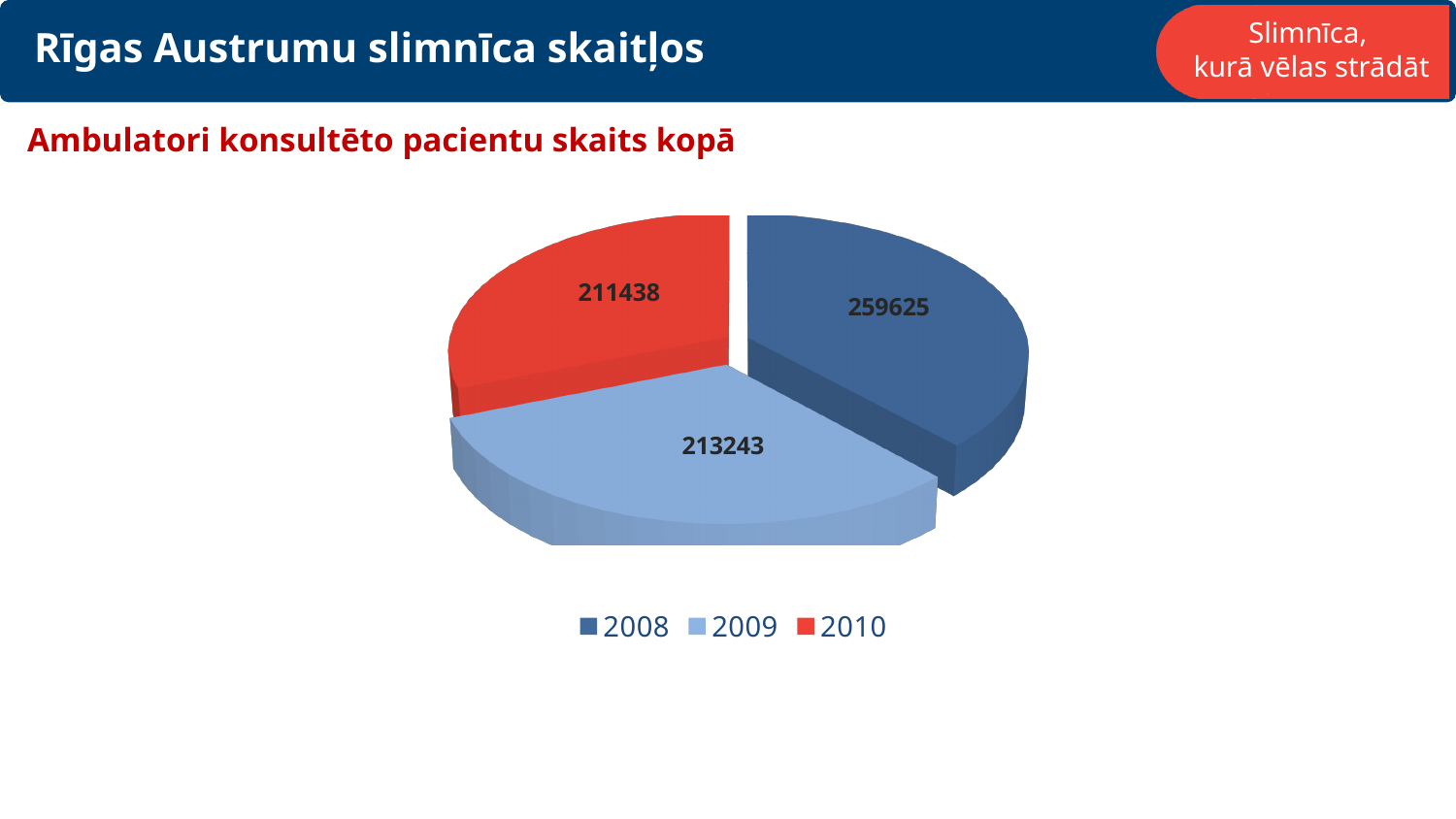
What is the title of the chart? Ambulatori konsultēto pacientu skaits kopā Which is larger, the value for 2008 or the value for 2010? 2008 Which colour represents 2010 in the pie chart? red What is the value for 2010 in the pie chart? 211438 What kind of chart is shown on the slide? pie chart How many slices does the pie chart have? 3 What is the difference between the values for 2008 and 2009? 46382 What is the value for 2009 in the pie chart? 213243 What is the difference between the values for 2009 and 2010? 1805 Which year has the smallest slice in the pie chart? 2010 What is the value for 2008 in the pie chart? 259625 Which year has the largest slice in the pie chart? 2008